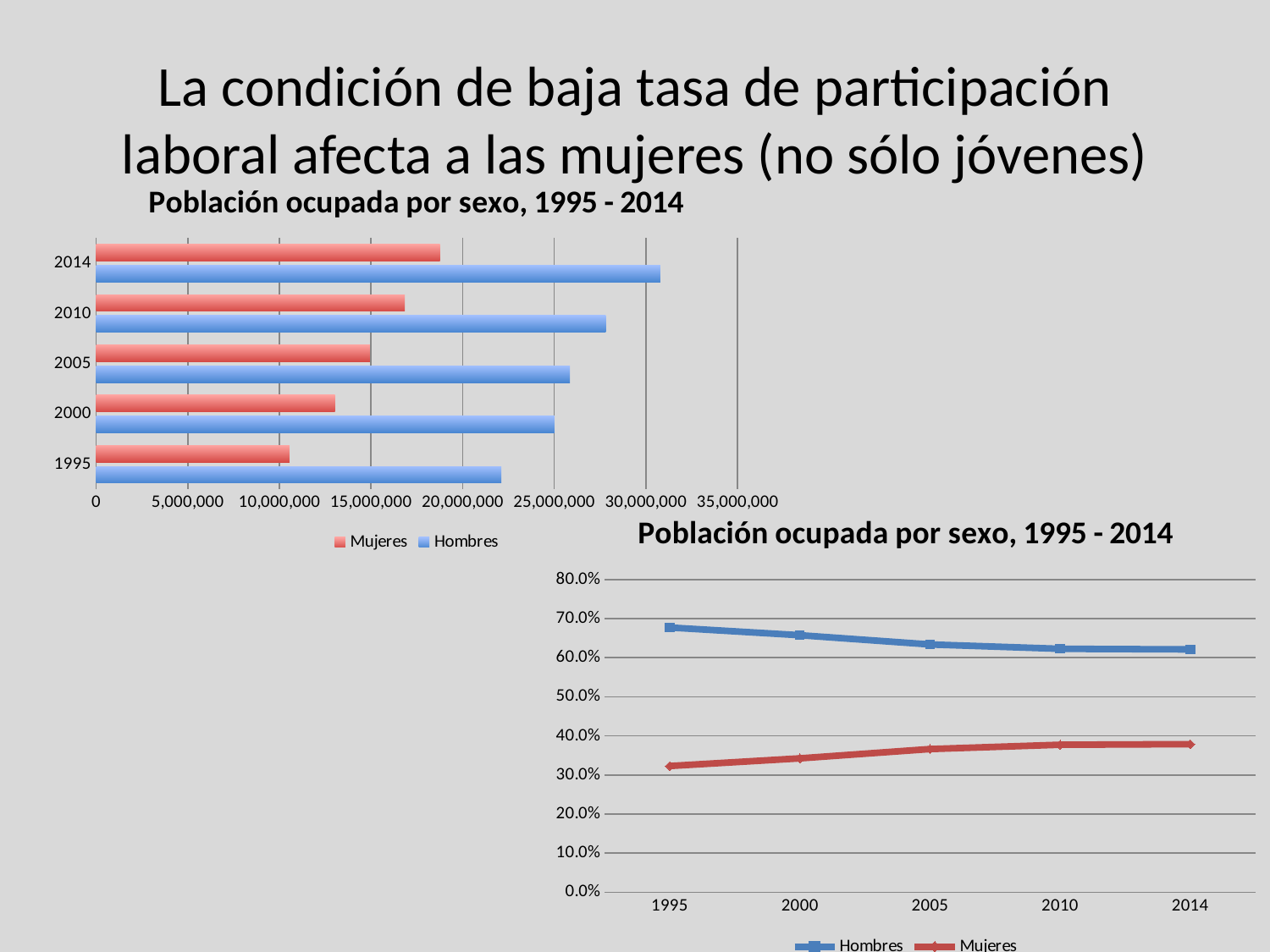
In the top-left bar chart, which year has the lowest Hombres value? 1995 In the bottom-right line chart, what colour is the Mujeres line? red What kind of chart is the top-left chart on the slide? bar chart In the top-left bar chart, how many series does the legend list? 2 In the top-left bar chart, is the Hombres value for 2014 greater or less than 30,000,000? greater In the top-left bar chart, how many years are shown on the vertical axis? 5 In the top-left bar chart, which is larger in 2005: the Mujeres bar or the Hombres bar? Hombres In the top-left bar chart, is the Mujeres value for 1995 greater or less than 15,000,000? less What kind of chart is the bottom-right chart on the slide? line chart In the bottom-right line chart, does the Hombres line rise or fall from 1995 to 2014? fall In the bottom-right line chart, is the Mujeres value for 2014 greater or less than 30.0%? greater In the top-left bar chart, which year has the highest Mujeres value? 2014